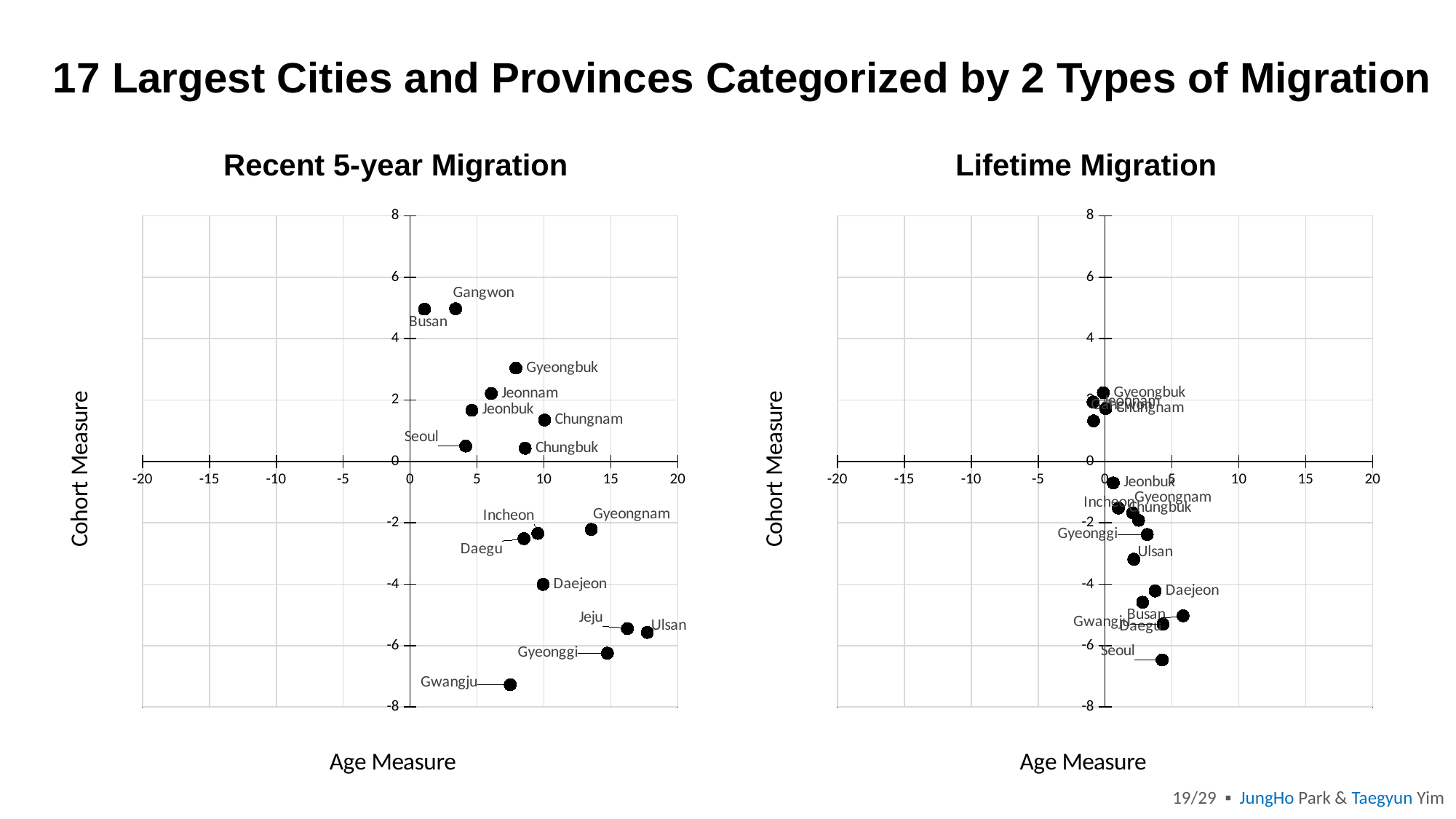
In the Recent 5-year Migration chart, is the cohort measure for Gyeongbuk greater or less than 2? greater In the Lifetime Migration chart, which city or province has the lowest cohort measure? Seoul In the Recent 5-year Migration chart, is the cohort measure for Gwangju greater or less than -6? less In the Recent 5-year Migration chart, is the age measure for Gyeongnam greater or less than 10? greater What kind of chart is the Recent 5-year Migration chart? scatter chart What is the title of the horizontal axis on the Lifetime Migration chart? Age Measure In the Recent 5-year Migration chart, which city or province has the lowest cohort measure? Gwangju In the Recent 5-year Migration chart, which city or province has the highest age measure? Ulsan In the Recent 5-year Migration chart, which has the larger cohort measure, Daejeon or Gyeongnam? Gyeongnam